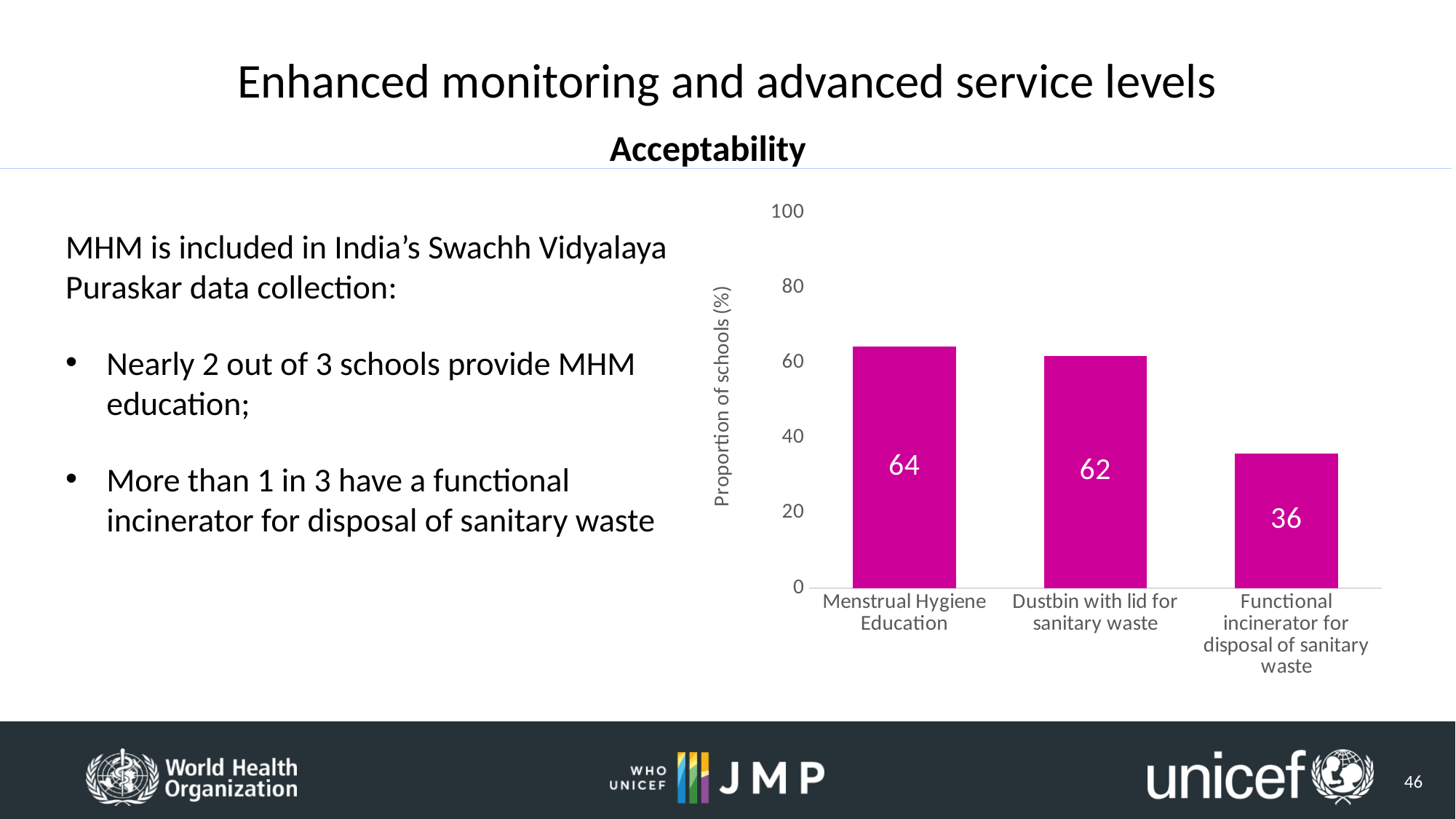
Which category has the highest value? Menstrual Hygiene Education What is the difference between the values for Menstrual Hygiene Education and Functional incinerator for disposal of sanitary waste? 28 Is the value for Functional incinerator for disposal of sanitary waste greater or less than 40? less Which category has the lowest value? Functional incinerator for disposal of sanitary waste What is the label of the vertical axis of the chart? Proportion of schools (%) What is the difference between the values for Dustbin with lid for sanitary waste and Functional incinerator for disposal of sanitary waste? 26 What is the value for Functional incinerator for disposal of sanitary waste? 36 What is the value for Dustbin with lid for sanitary waste? 62 What is the value for Menstrual Hygiene Education? 64 Which is larger: the value for Dustbin with lid for sanitary waste or the value for Functional incinerator for disposal of sanitary waste? Dustbin with lid for sanitary waste What kind of chart is shown on the slide? Bar chart How many categories are shown in the chart? 3